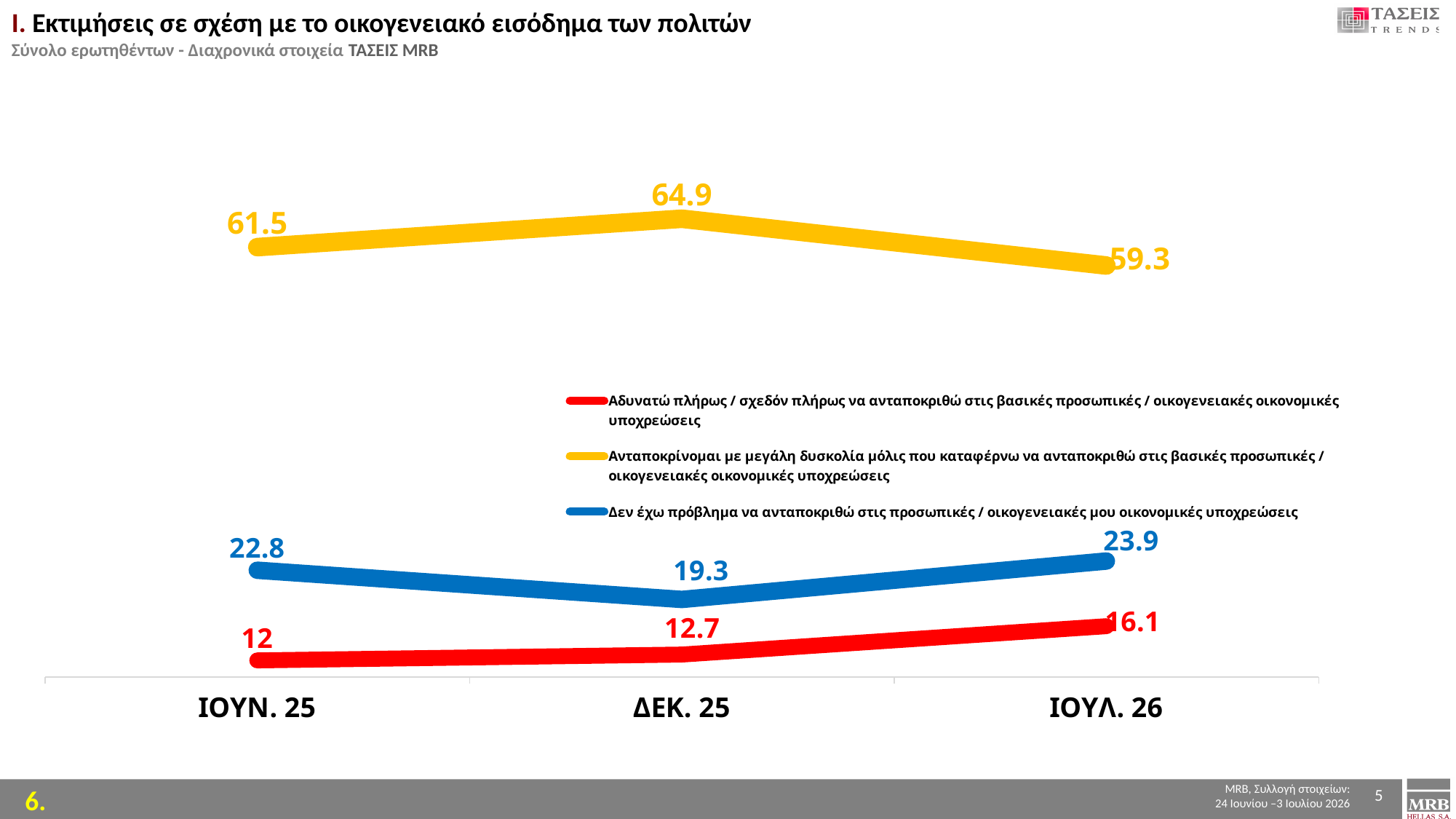
How many series does the legend list? 3 What type of chart is shown on the slide? line chart What is the value of the yellow series (Ανταποκρίνομαι με μεγάλη δυσκολία) at ΔΕΚ. 25? 64.9 Which is larger at ΙΟΥΝ. 25: the blue series or the red series? the blue series (22.8) At which time point does the yellow series reach its highest value? ΔΕΚ. 25 What is the difference between the yellow series values at ΔΕΚ. 25 and ΙΟΥΛ. 26? 5.6 How many time points are plotted along the x axis? 3 What is the value of the red series (Αδυνατώ πλήρως / σχεδόν πλήρως) at ΙΟΥΝ. 25? 12 What is the value of the blue series (Δεν έχω πρόβλημα) at ΙΟΥΛ. 26? 23.9 Does the red series rise or fall from ΙΟΥΝ. 25 to ΙΟΥΛ. 26? rise By how much did the red series increase from ΙΟΥΝ. 25 to ΙΟΥΛ. 26? 4.1 At which time point is the blue series at its lowest value? ΔΕΚ. 25